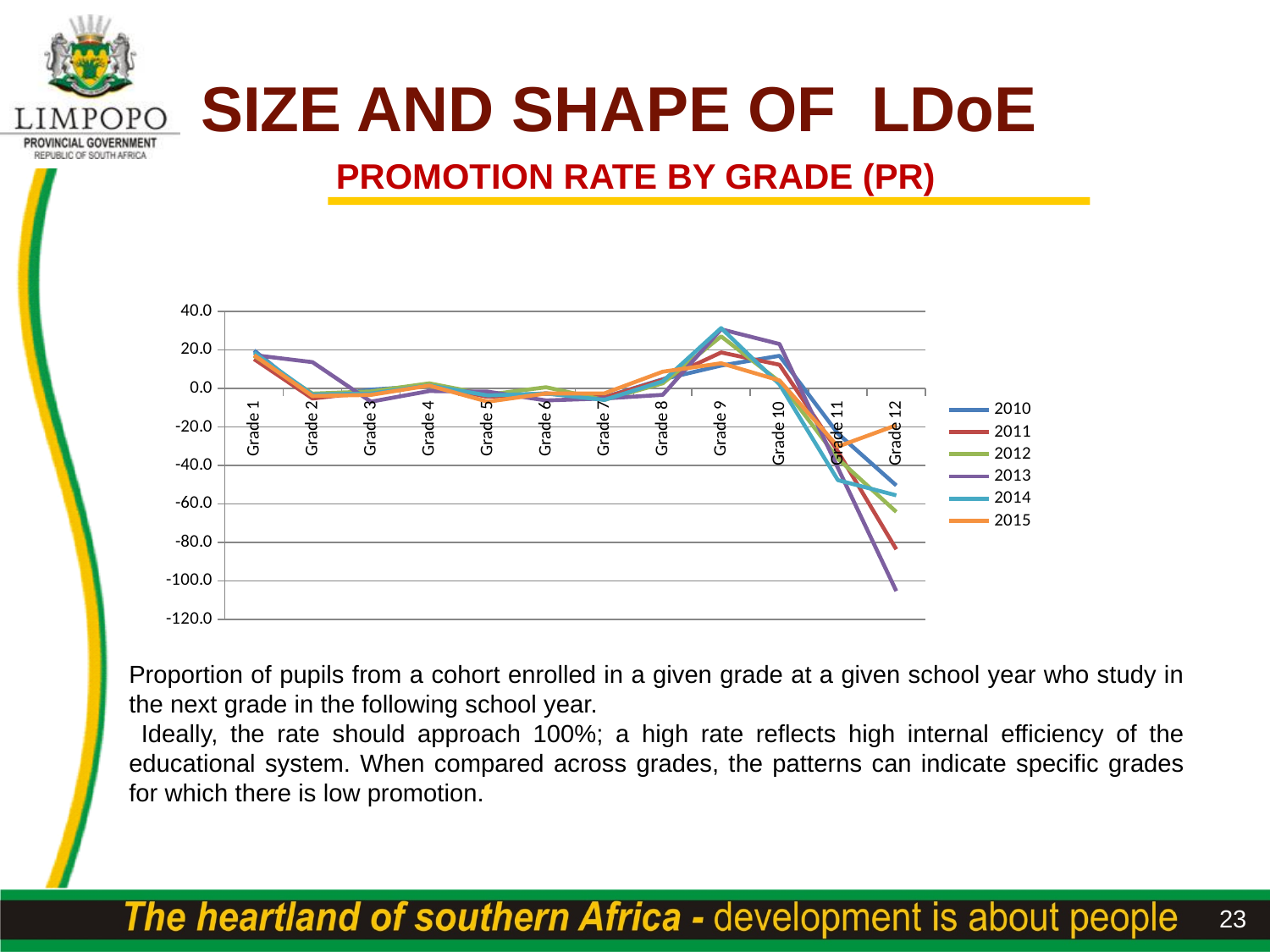
For the 2013 series, which grade has the lowest value? Grade 12 How many grade categories are plotted along the x axis? 12 Is the value for 2011 at Grade 12 greater or less than -60? less How many series does the legend list? 6 Do the values for the 2013 series rise or fall from Grade 10 to Grade 12? fall Which series are listed in the legend? 2010, 2011, 2012, 2013, 2014, 2015 Is the value for 2015 at Grade 12 greater or less than -40? greater What is the title shown above the chart? PROMOTION RATE BY GRADE (PR) Is the value for 2013 at Grade 12 greater or less than -80? less What kind of chart is shown on the slide? line chart For the 2013 series, which grade has the highest value? Grade 9 At Grade 12, which series has the larger value, 2015 or 2013? 2015